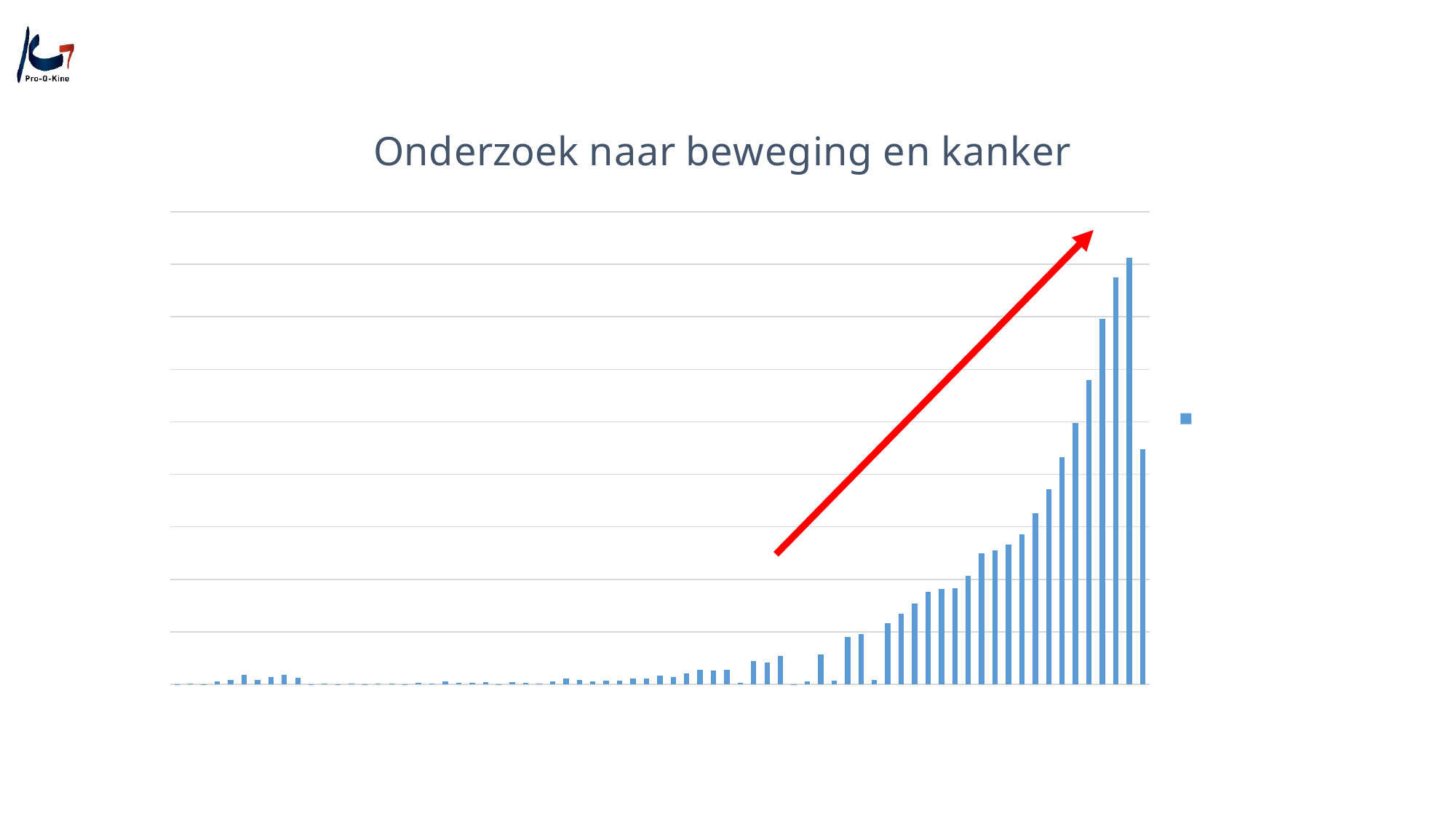
Do the bar values generally rise or fall from left to right along the x axis? rise Which is taller: the last bar on the right or the bar immediately before it? the bar immediately before it What kind of chart is shown on the slide? bar chart What colour are the bars in the chart? blue Is the tallest bar located near the left end or the right end of the chart? right end What is the title of the chart? Onderzoek naar beweging en kanker How many series does the legend list? 1